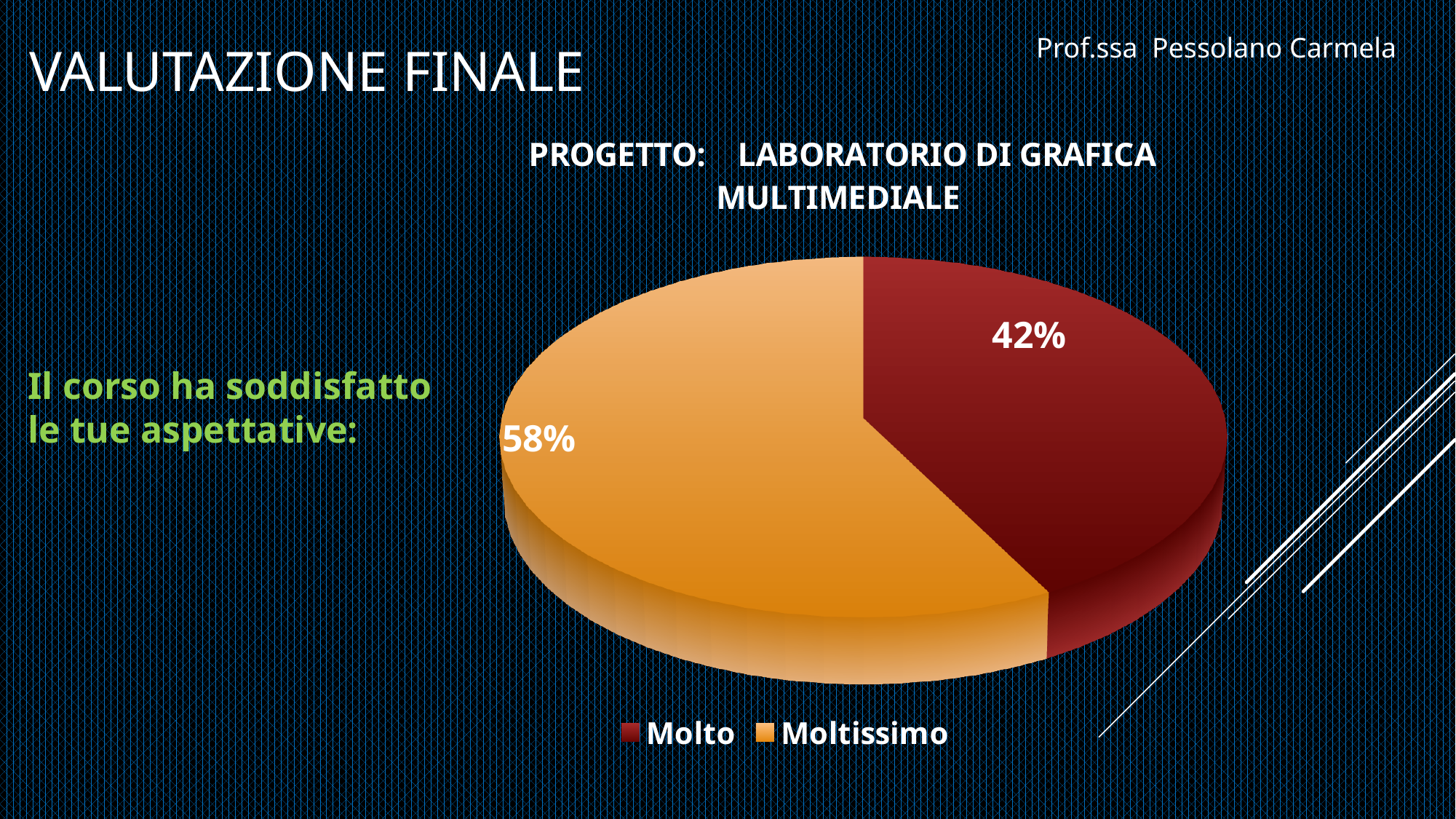
Which slice is larger, "Molto" or "Moltissimo"? Moltissimo Which category has the smallest slice of the pie? Molto What colour is the "Molto" slice in the pie chart? Dark red What kind of chart is shown on the slide? Pie chart How many entries does the legend list? 2 What share of the pie does the "Moltissimo" slice represent? 58% What share of the pie does the "Molto" slice represent? 42% How many slices does the pie chart have? 2 What is the title of the chart? PROGETTO: LABORATORIO DI GRAFICA MULTIMEDIALE What is the difference in percentage points between the "Moltissimo" and "Molto" slices? 16% What is the total of the two slices shown in the pie chart? 100% Which category has the largest slice of the pie? Moltissimo